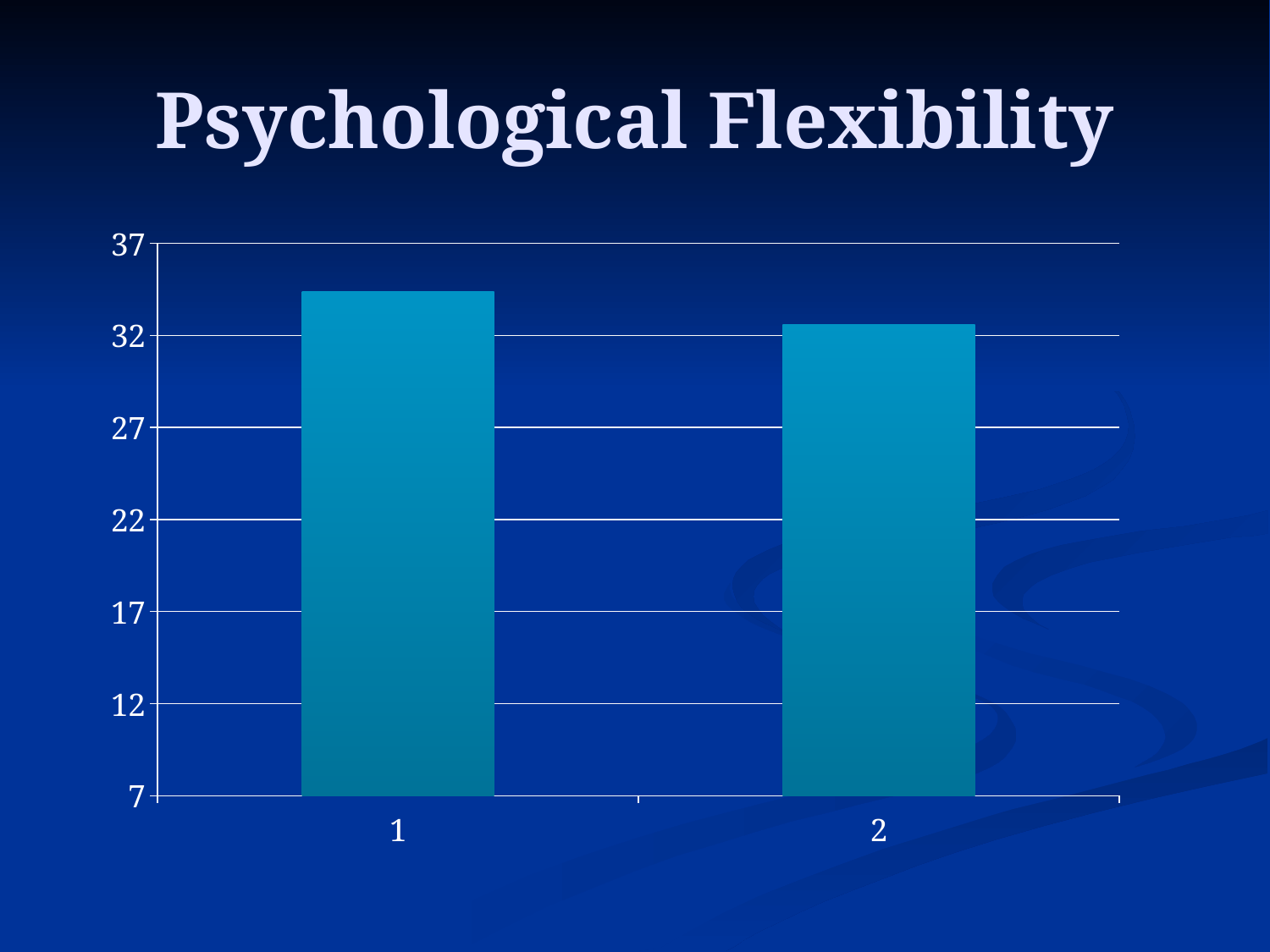
Which bar is taller, category 1 or category 2? 1 Do the values rise or fall from category 1 to category 2? fall What is the title of the chart? Psychological Flexibility What is the lowest value shown on the vertical axis? 7 Which category has the lowest bar? 2 Which category has the highest bar? 1 How many bars are plotted in the chart? 2 Is the value for category 2 greater or less than 27? greater Is the value for category 2 greater or less than 37? less Is the value for category 1 greater or less than 37? less What kind of chart is shown on the slide? bar chart